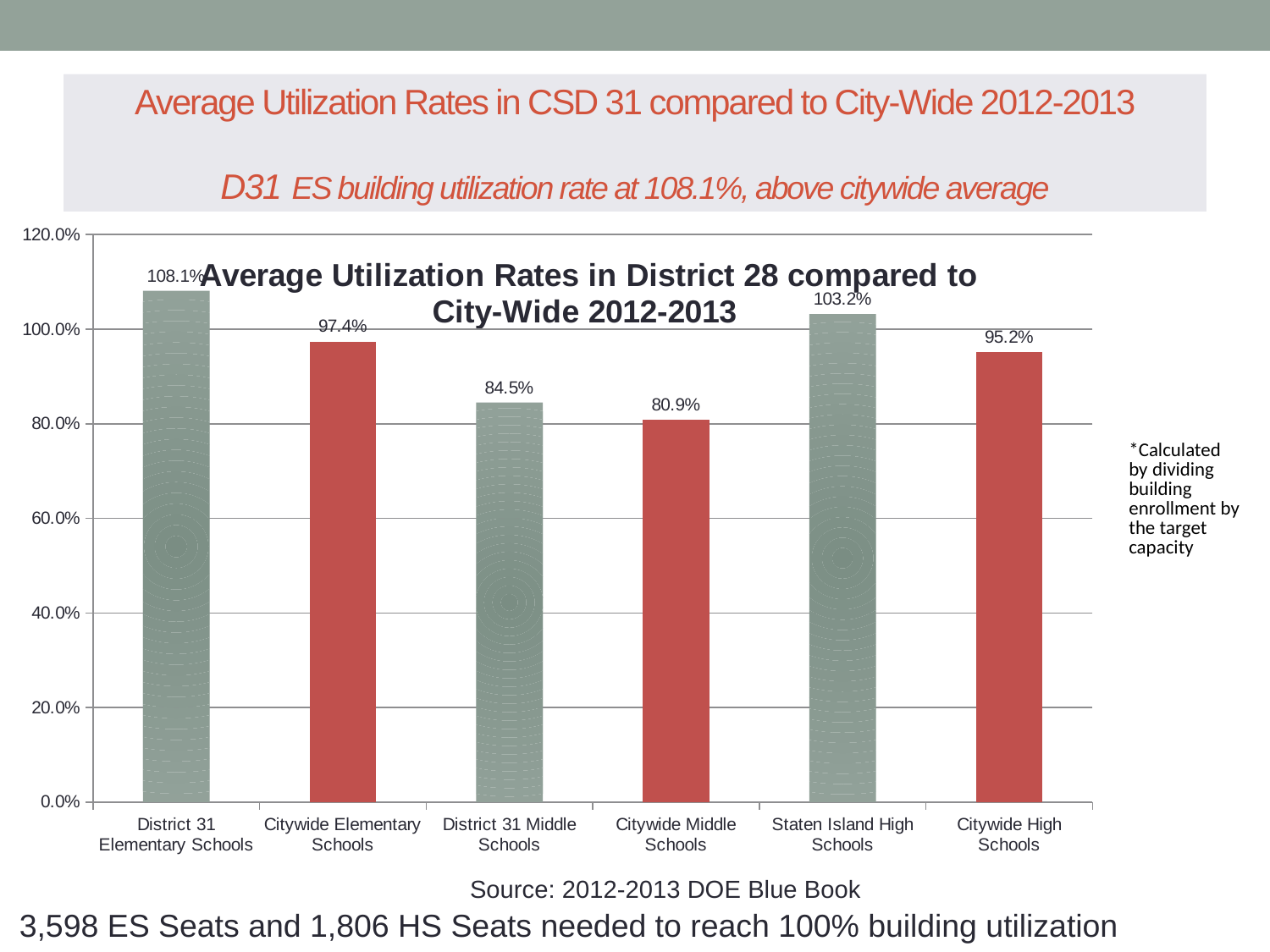
Which category has the highest utilization rate? District 31 Elementary Schools What is the average utilization rate for Citywide Middle Schools? 80.9% What is the average utilization rate for District 31 Elementary Schools? 108.1% Is the value for Citywide High Schools greater or less than 100.0%? less What is the difference between the utilization rates of Staten Island High Schools and Citywide High Schools? 8.0% Which category has the lowest utilization rate? Citywide Middle Schools What is the title printed inside the chart area? Average Utilization Rates in District 28 compared to City-Wide 2012-2013 How many categories are shown on the x axis? 6 What kind of chart is shown on the slide? Bar chart What is the difference between the utilization rates of District 31 Elementary Schools and Citywide Elementary Schools? 10.7% What is the average utilization rate for Staten Island High Schools? 103.2% Which is larger, the utilization rate for District 31 Middle Schools or Citywide Middle Schools? District 31 Middle Schools